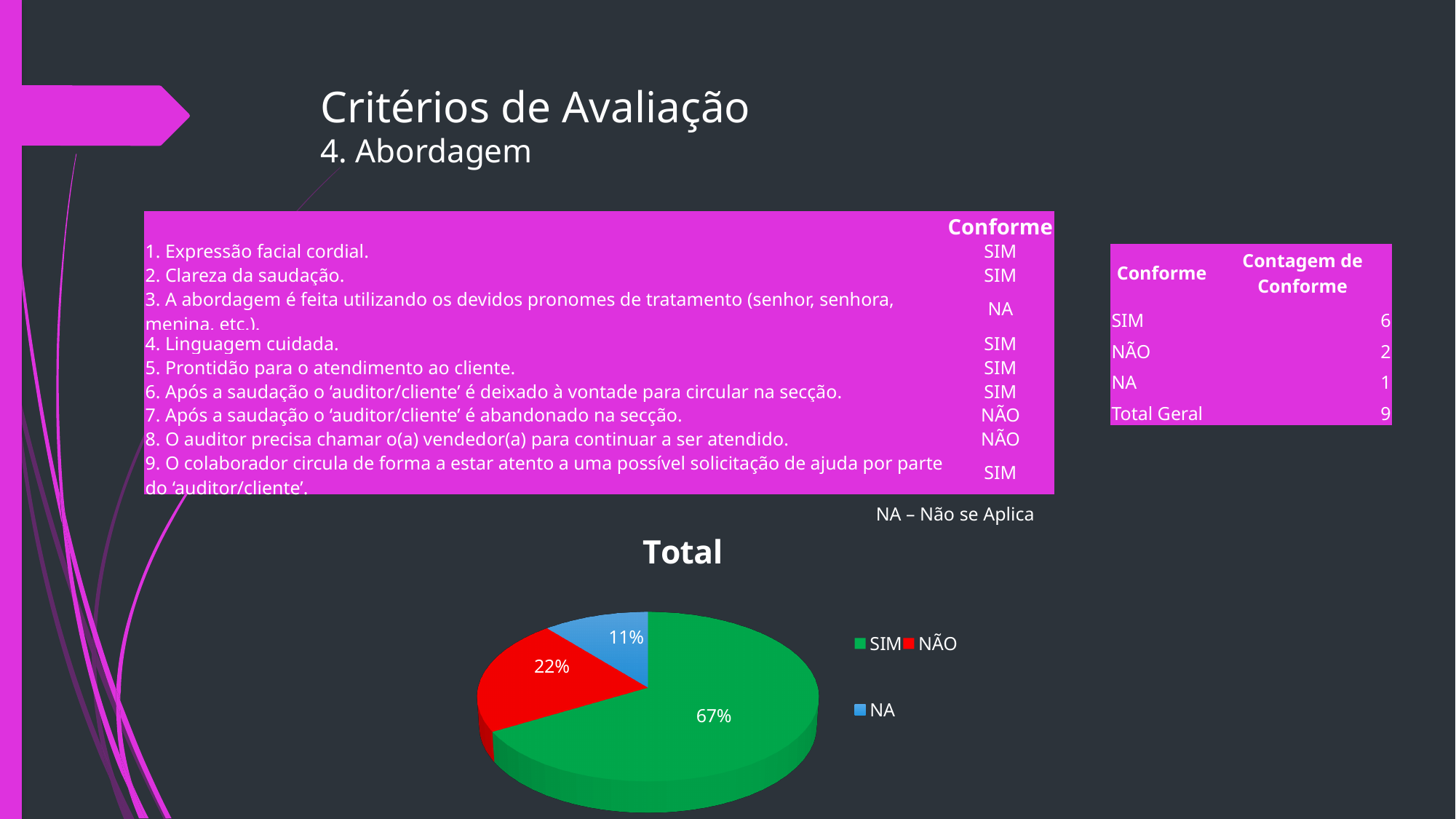
What share of the pie does NA represent? 11% How many entries does the legend of the pie chart list? 3 Which category has the smallest slice of the pie? NA How many slices does the pie chart have? 3 Which category has the largest slice of the pie? SIM What is the title of the pie chart? Total What is the difference in percentage points between the SIM slice and the NÃO slice? 45 What share of the pie does SIM represent? 67% What kind of chart is shown on the slide? pie chart Which is larger, the NÃO slice or the NA slice? NÃO What colour is the SIM slice in the pie chart? green What share of the pie does NÃO represent? 22%